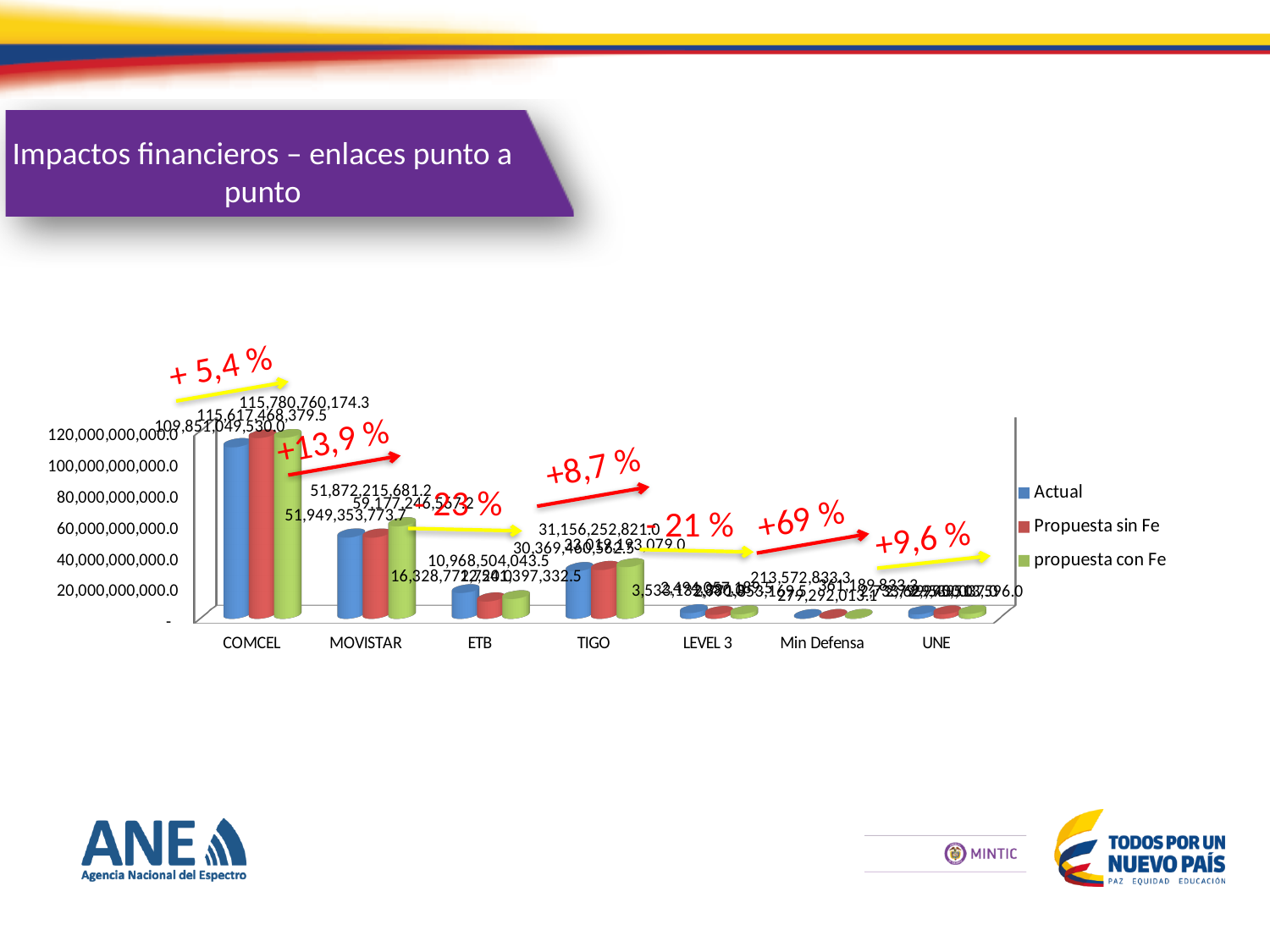
What is the 'Propuesta sin Fe' value for COMCEL? 115,617,468,379.5 Which has a larger Actual value, COMCEL or MOVISTAR? COMCEL How many series does the legend list? 3 What is the 'propuesta con Fe' value for COMCEL? 115,780,760,174.3 What is the difference between the 'propuesta con Fe' value and the Actual value for COMCEL? 5,929,710,644.3 What percentage change is annotated above the COMCEL bars? + 5,4 % What kind of chart is shown on the slide? Bar chart How many categories are shown on the x axis? 7 Which category has the highest values in the chart? COMCEL Is the Actual value for MOVISTAR greater or less than 40,000,000,000.0? greater What is the Actual value for COMCEL? 109,851,049,530.0 Is the Actual value for ETB greater or less than 20,000,000,000.0? less